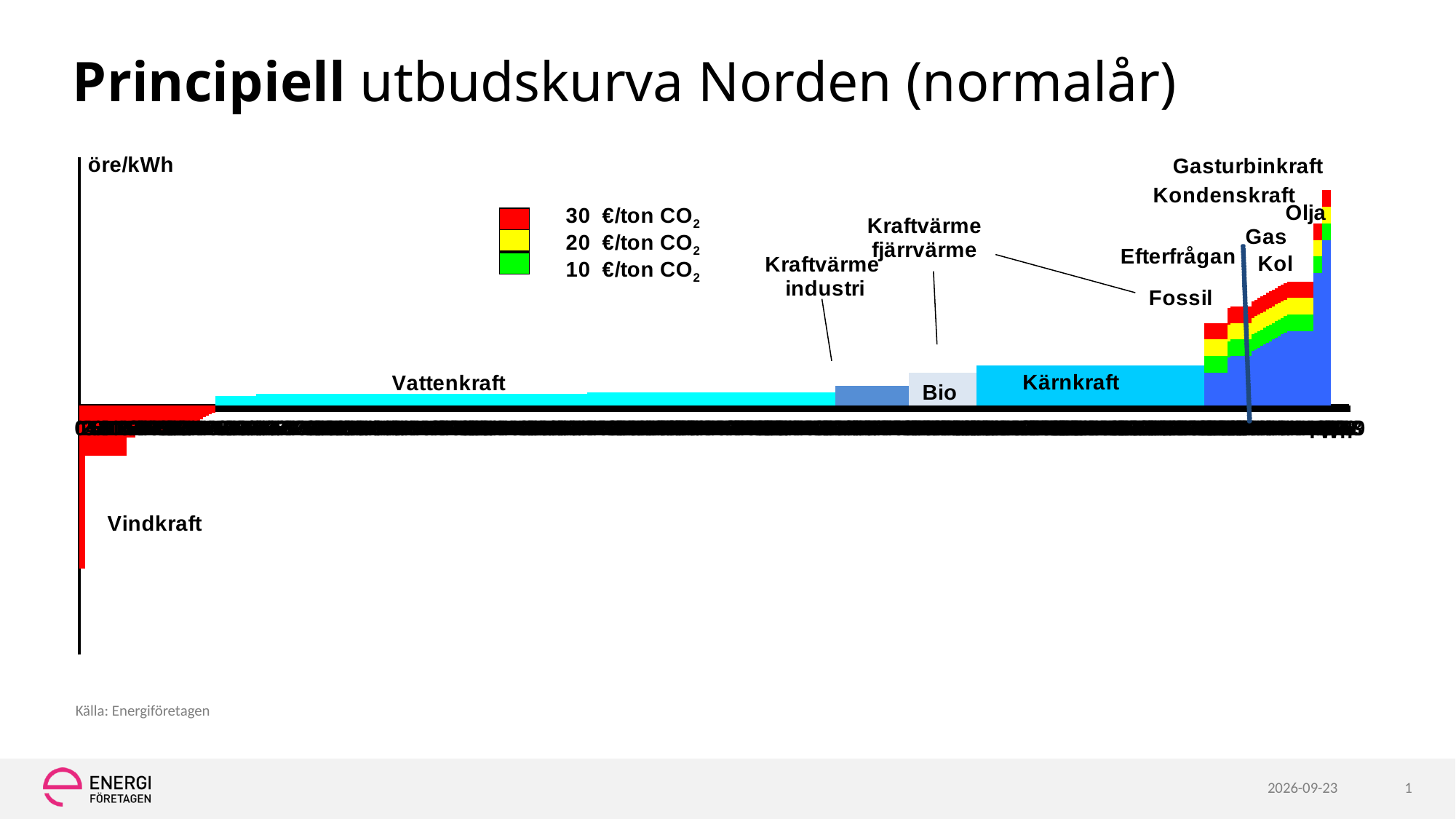
How many CO2 price levels does the legend list? 3 Which technology is at the highest point of the supply curve? Gasturbinkraft Which technology is plotted below the horizontal axis, with a negative value? Vindkraft Is Bio plotted higher or lower on the curve than Kärnkraft? Lower What unit is shown on the vertical axis of the chart? öre/kWh Do the values of the supply curve rise or fall from left to right? Rise Which colour in the legend represents 30 €/ton CO2? Red Is Kärnkraft plotted higher or lower on the curve than Vattenkraft? Higher Which is plotted higher on the curve, Fossil or Bio? Fossil